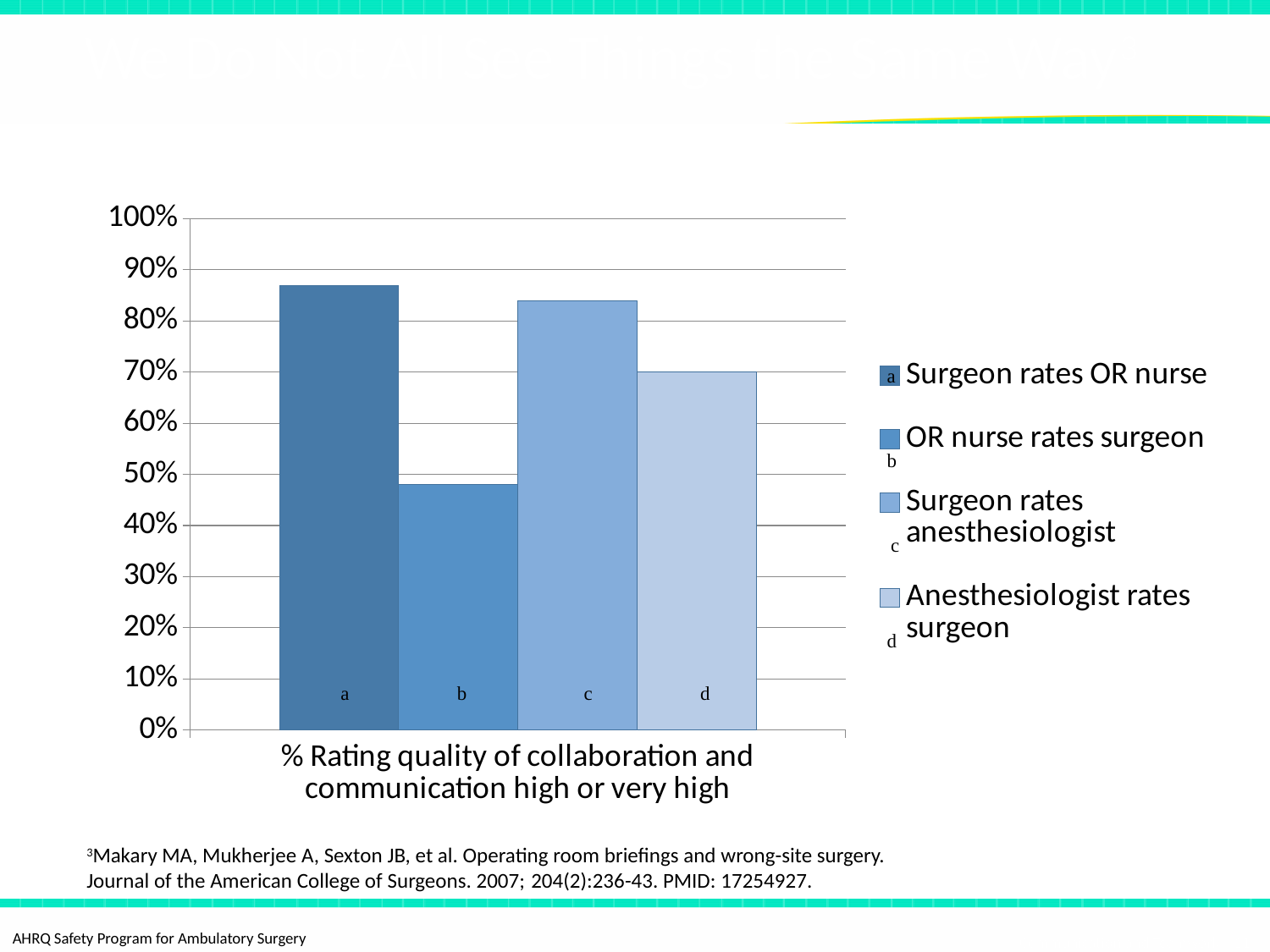
Which is larger: the value for Surgeon rates OR nurse or the value for OR nurse rates surgeon? Surgeon rates OR nurse What kind of chart is shown on the slide? bar chart Is the value for Surgeon rates anesthesiologist greater or less than 80%? greater Which series has the lowest value? OR nurse rates surgeon Which is larger: the value for Surgeon rates anesthesiologist or the value for Anesthesiologist rates surgeon? Surgeon rates anesthesiologist Which series has the highest value? Surgeon rates OR nurse How many series does the legend list? 4 Is the value for OR nurse rates surgeon greater or less than 50%? less Which legend entry corresponds to the lightest-coloured bar (labelled d)? Anesthesiologist rates surgeon Is the value for Anesthesiologist rates surgeon greater or less than 60%? greater What is the label shown on the x axis of the chart? % Rating quality of collaboration and communication high or very high